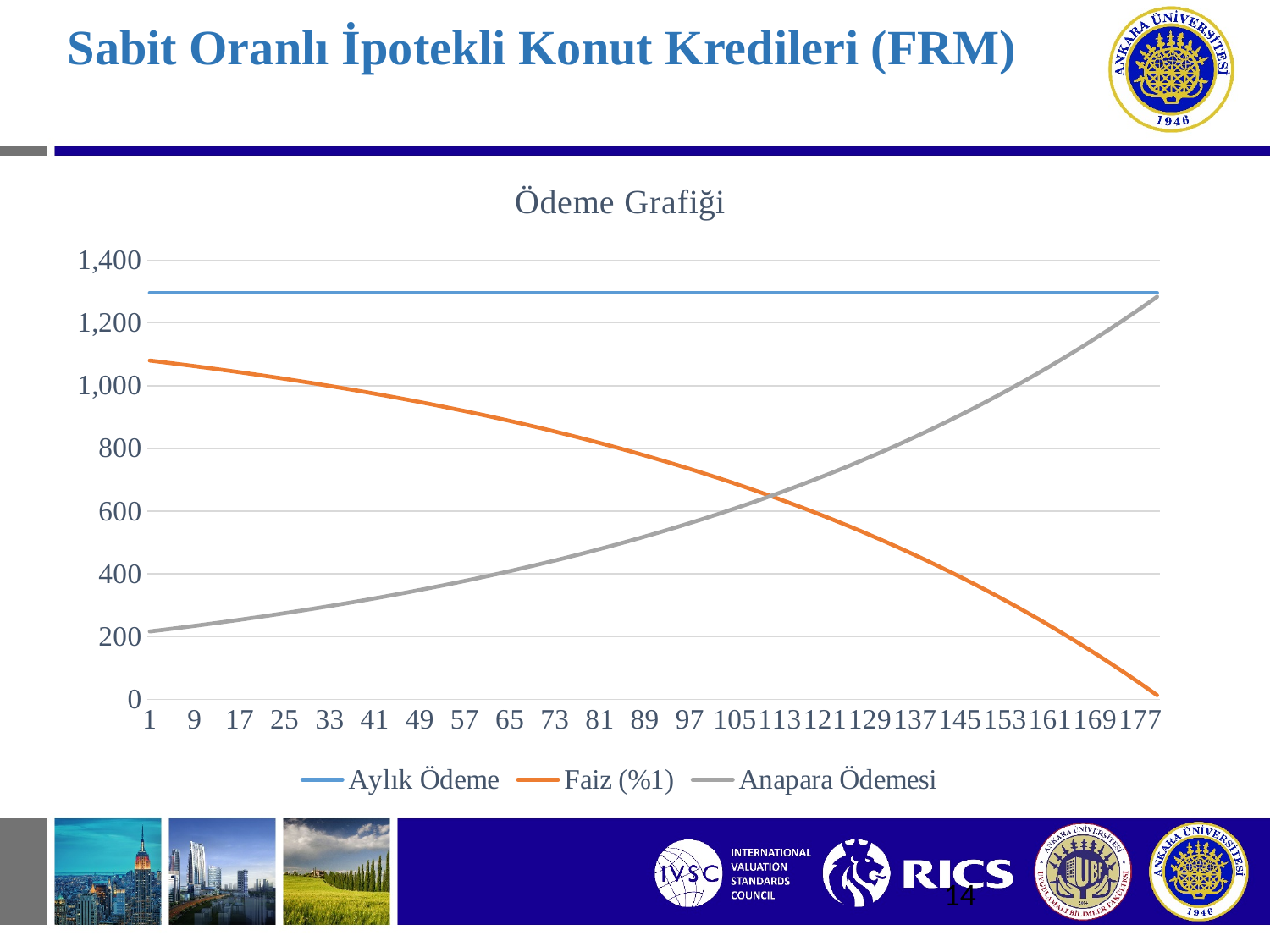
Does the Anapara Ödemesi series rise or fall along the x axis? rise Is the value of Anapara Ödemesi at x = 1 greater or less than 400? less What kind of chart is shown on the slide? line chart Is the value of Faiz (%1) at x = 1 greater or less than 1,000? greater Is the value of Faiz (%1) at x = 177 greater or less than 200? less How many series does the legend list? 3 At x = 1, which is larger: Faiz (%1) or Anapara Ödemesi? Faiz (%1) Which series is shown in orange? Faiz (%1) At x = 177, which is larger: Faiz (%1) or Anapara Ödemesi? Anapara Ödemesi What is the title of the chart? Ödeme Grafiği Does the Faiz (%1) series rise or fall along the x axis? fall